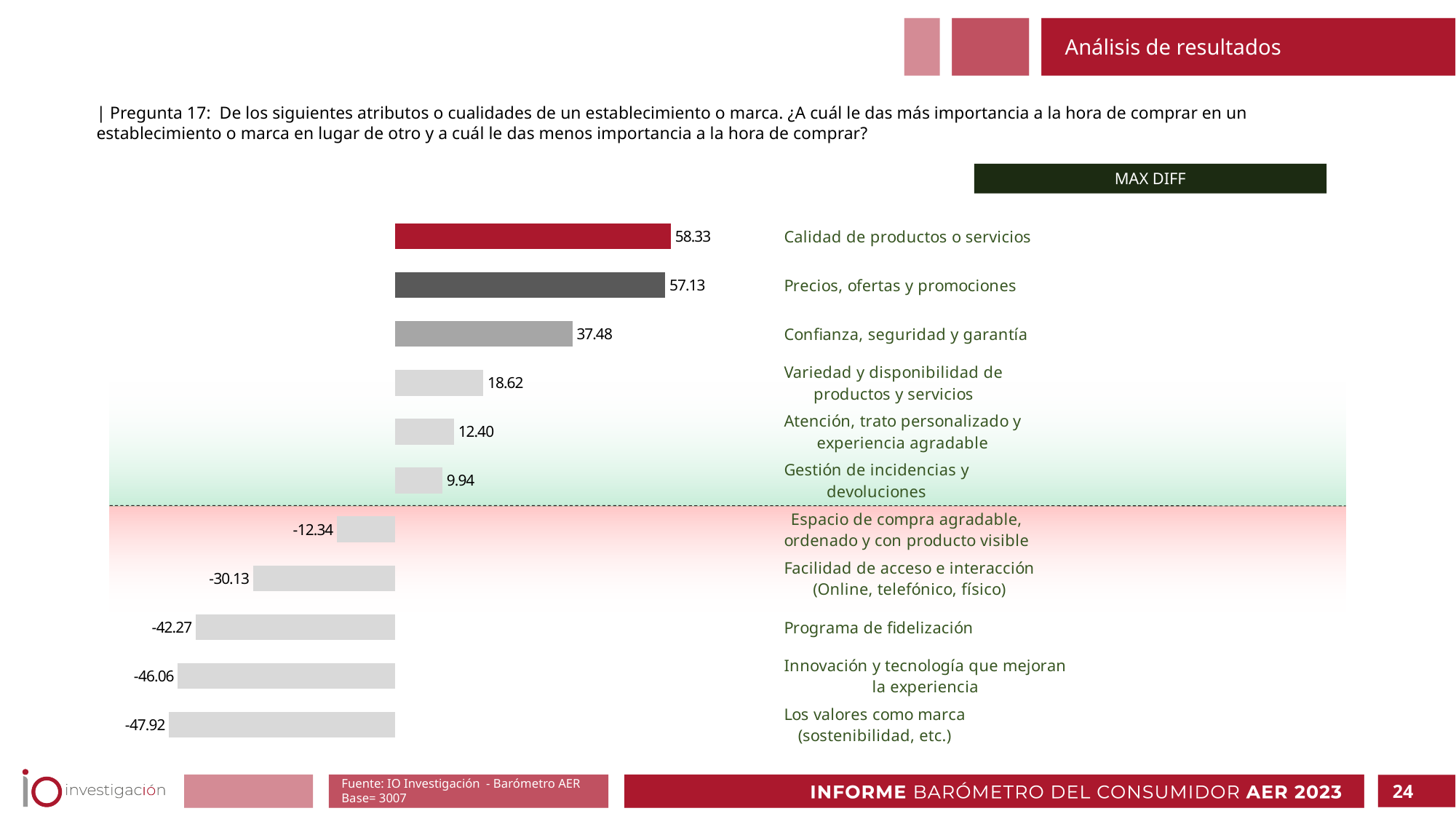
Which has a larger value: "Precios, ofertas y promociones" or "Confianza, seguridad y garantía"? Precios, ofertas y promociones What is the difference between the values for "Confianza, seguridad y garantía" and "Variedad y disponibilidad de productos y servicios"? 18.86 How many attributes have a negative value in the chart? 5 How many attributes (bars) are shown in the chart? 11 What is the value shown for "Gestión de incidencias y devoluciones"? 9.94 What is the difference between the values for "Calidad de productos o servicios" and "Precios, ofertas y promociones"? 1.20 What is the value shown for "Programa de fidelización"? -42.27 Which has a larger value: "Facilidad de acceso e interacción (Online, telefónico, físico)" or "Espacio de compra agradable, ordenado y con producto visible"? Espacio de compra agradable, ordenado y con producto visible What kind of chart is shown on the slide? Bar chart Which attribute has the lowest value in the chart? Los valores como marca (sostenibilidad, etc.) What is the MAX DIFF value for "Calidad de productos o servicios"? 58.33 Which attribute has the highest value in the chart? Calidad de productos o servicios